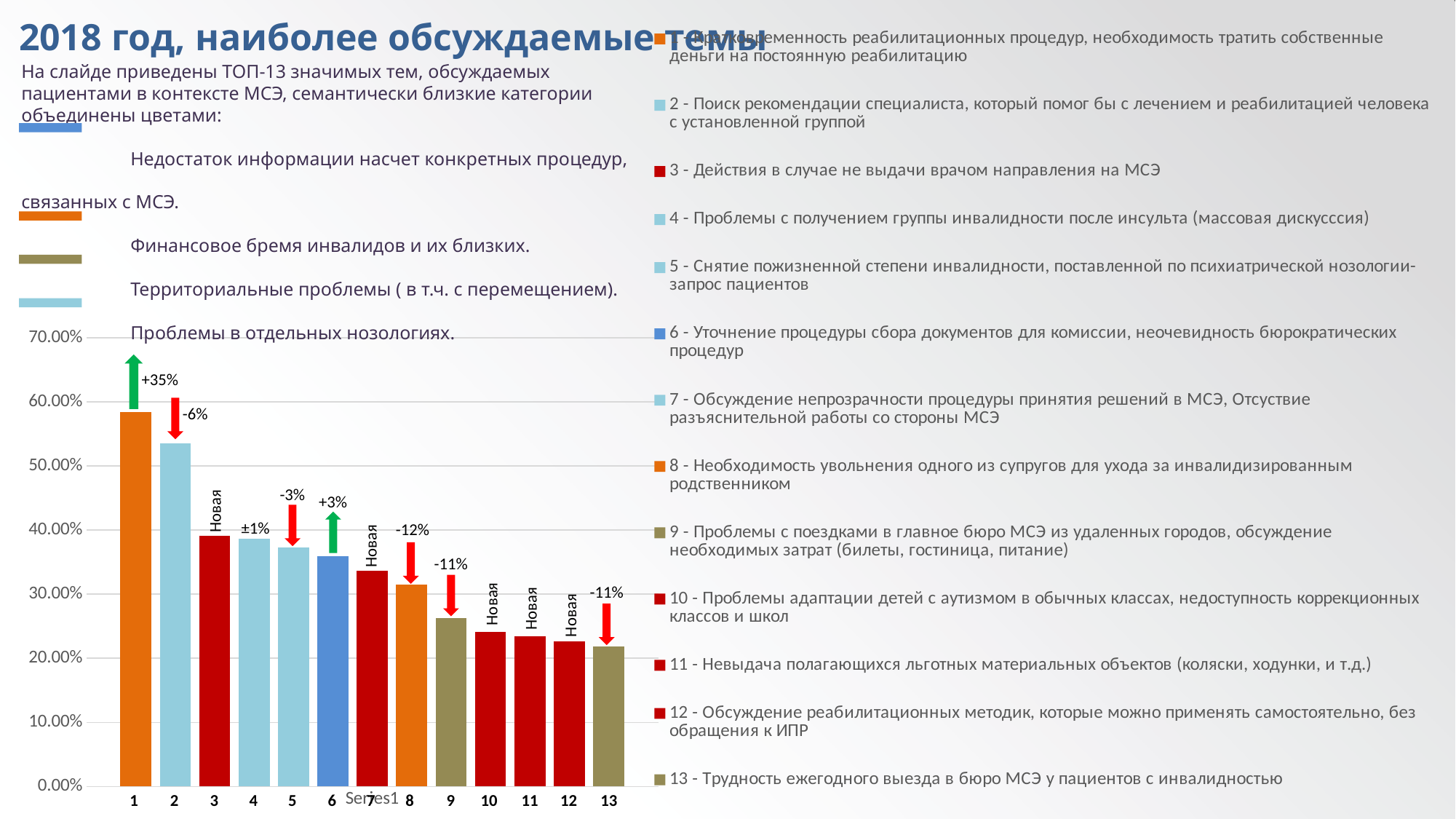
Which category has the highest bar in the chart? 1 Which is larger, the value for category 1 or the value for category 2? category 1 Is the value for category 13 greater or less than 20%? greater Is the value for category 6 greater or less than 30%? greater Do the bar values generally rise or fall from category 1 to category 13? fall What kind of chart is shown on the slide? bar chart Is the value for category 5 greater or less than 40%? less What change annotation is printed above the bar for category 1? +35% Which is larger, the value for category 3 or the value for category 9? category 3 How many categories (bars) does the chart show? 13